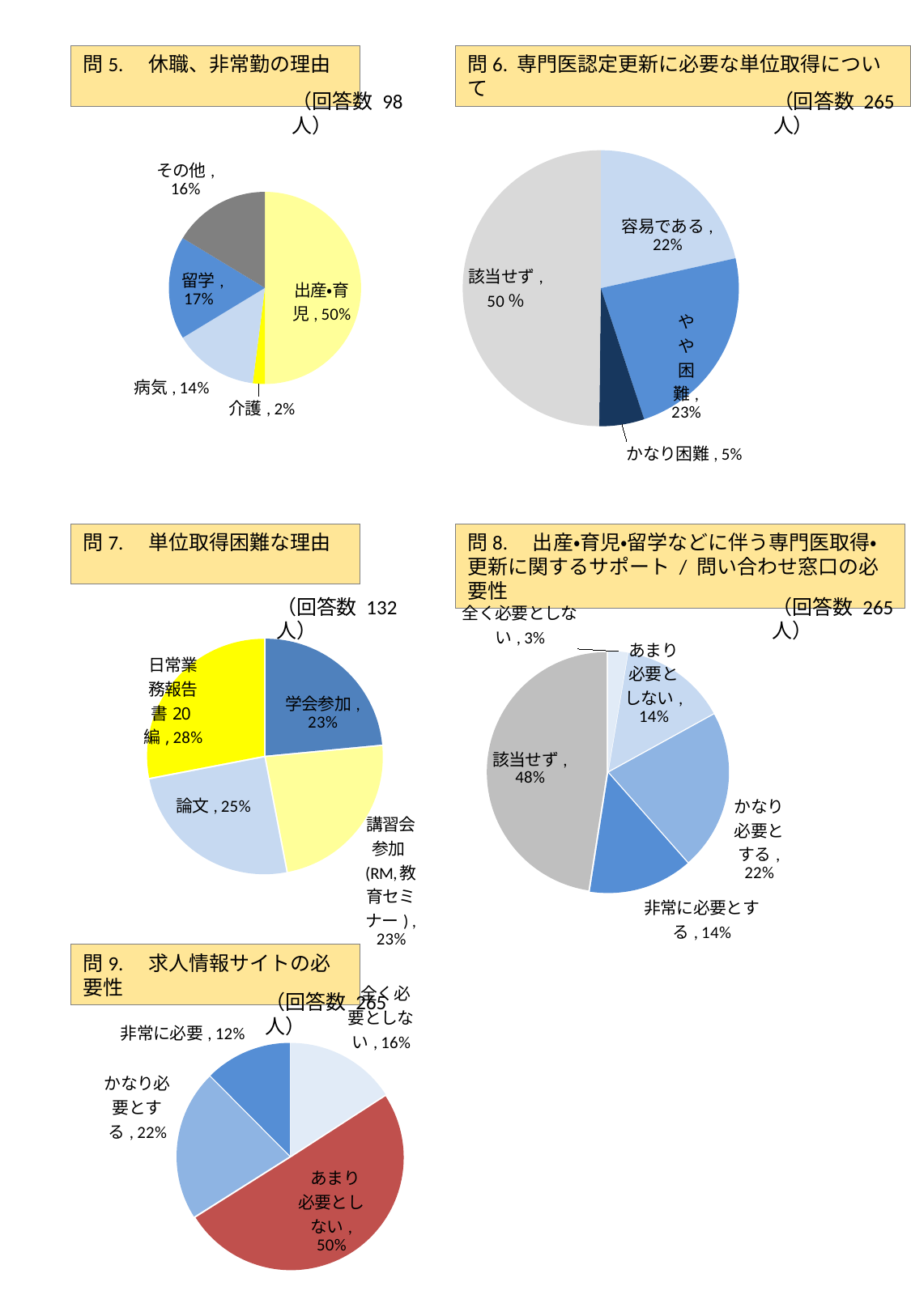
In the 問5 chart (休職、非常勤の理由), which category has the smallest slice? 介護 In the 問6 chart (専門医認定更新に必要な単位取得について), what percentage is shown for やや困難? 23% In the 問9 chart (求人情報サイトの必要性), what percentage is shown for あまり必要としない? 50% What type of chart is used for 問9 (求人情報サイトの必要性)? Pie chart In the 問6 chart (専門医認定更新に必要な単位取得について), what is the difference between 容易である and かなり困難? 17% How many slices does the 問5 pie chart (休職、非常勤の理由) have? 5 In the 問5 chart (休職、非常勤の理由), what share is labelled for 出産・育児? 50% In the 問8 chart, which is larger: かなり必要とする or 非常に必要とする? かなり必要とする In the 問7 chart (単位取得困難な理由), what percentage is shown for 論文? 25% In the 問7 chart (単位取得困難な理由), which category has the largest share? 日常業務報告書20編 In the 問6 chart (専門医認定更新に必要な単位取得について), which category has the largest slice? 該当せず In the 問8 chart (出産・育児・留学などに伴う専門医取得・更新に関するサポート／問い合わせ窓口の必要性), what percentage is shown for 該当せず? 48%